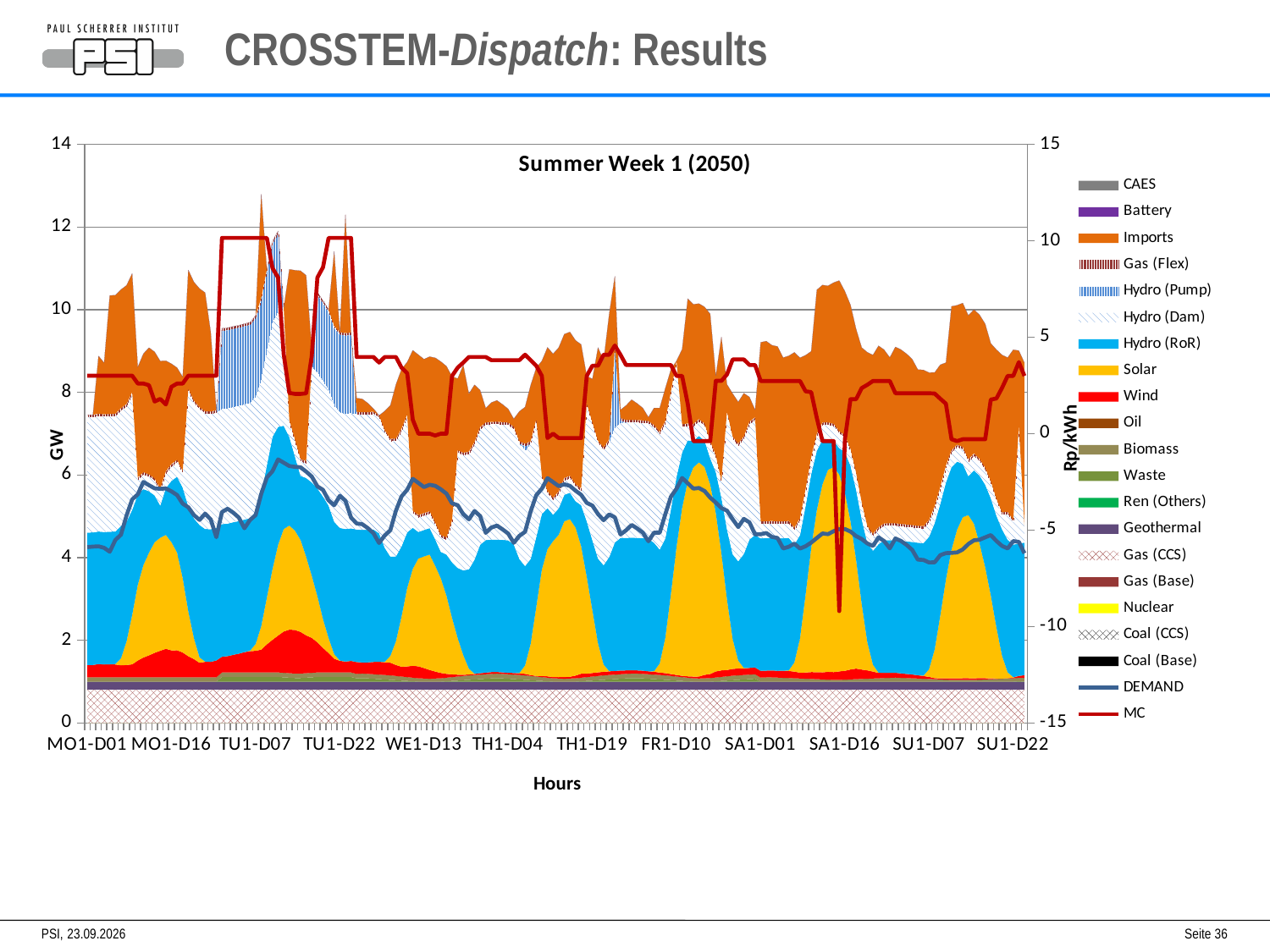
What is the title of the chart? Summer Week 1 (2050) Is the DEMAND value at MO1-D01 greater or less than 8 GW? less How many series does the legend list? 21 Is the DEMAND value at SU1-D22 greater or less than 6 GW? less What is the label of the left vertical axis? GW Is the highest level of the MC line (around TU1-D07) greater or less than 5 Rp/kWh? greater What kind of chart is shown on the slide? stacked area chart with line series